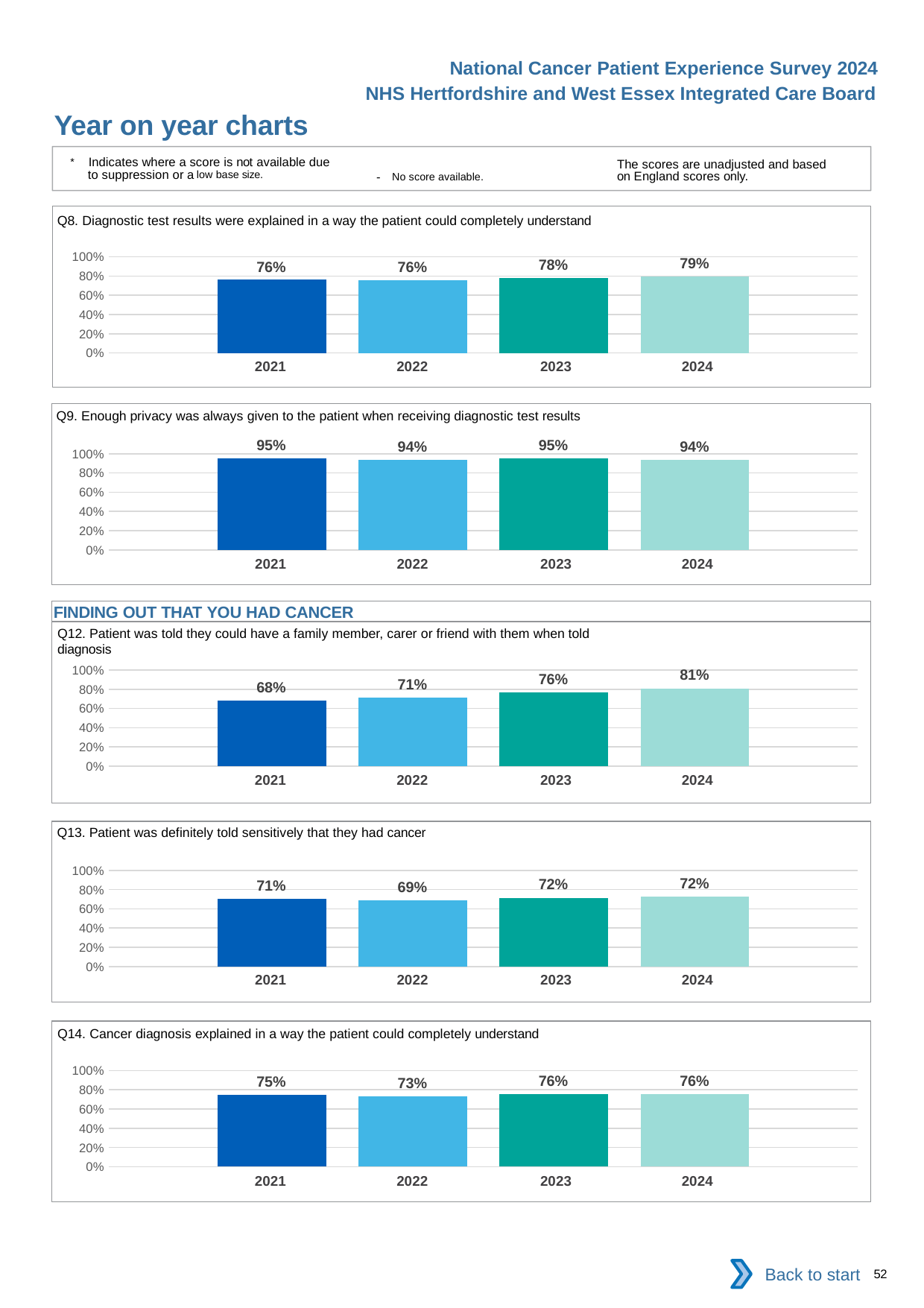
In the Q14 chart (Cancer diagnosis explained in a way the patient could completely understand), what is the value for 2022? 73% How many years are shown on the x axis of the Q14 chart? 4 In the Q12 chart, what is the difference between the 2024 and 2021 values? 13 percentage points In the Q8 chart, what is the difference between the 2024 and 2021 values? 3 percentage points In the Q13 chart, which is larger, the value for 2021 or the value for 2022? 2021 In the Q13 chart (Patient was definitely told sensitively that they had cancer), which year has the lowest value? 2022 In the Q9 chart, is the value for 2021 greater or less than 80%? greater In the Q12 chart, do the values rise or fall from 2021 to 2024? rise In the Q12 chart, which year has the lowest value? 2021 In the Q8 chart (Diagnostic test results were explained in a way the patient could completely understand), what is the value for 2024? 79% In the Q9 chart (Enough privacy was always given to the patient when receiving diagnostic test results), what is the value for 2022? 94% In the Q12 chart (Patient was told they could have a family member, carer or friend with them when told diagnosis), which year has the highest value? 2024